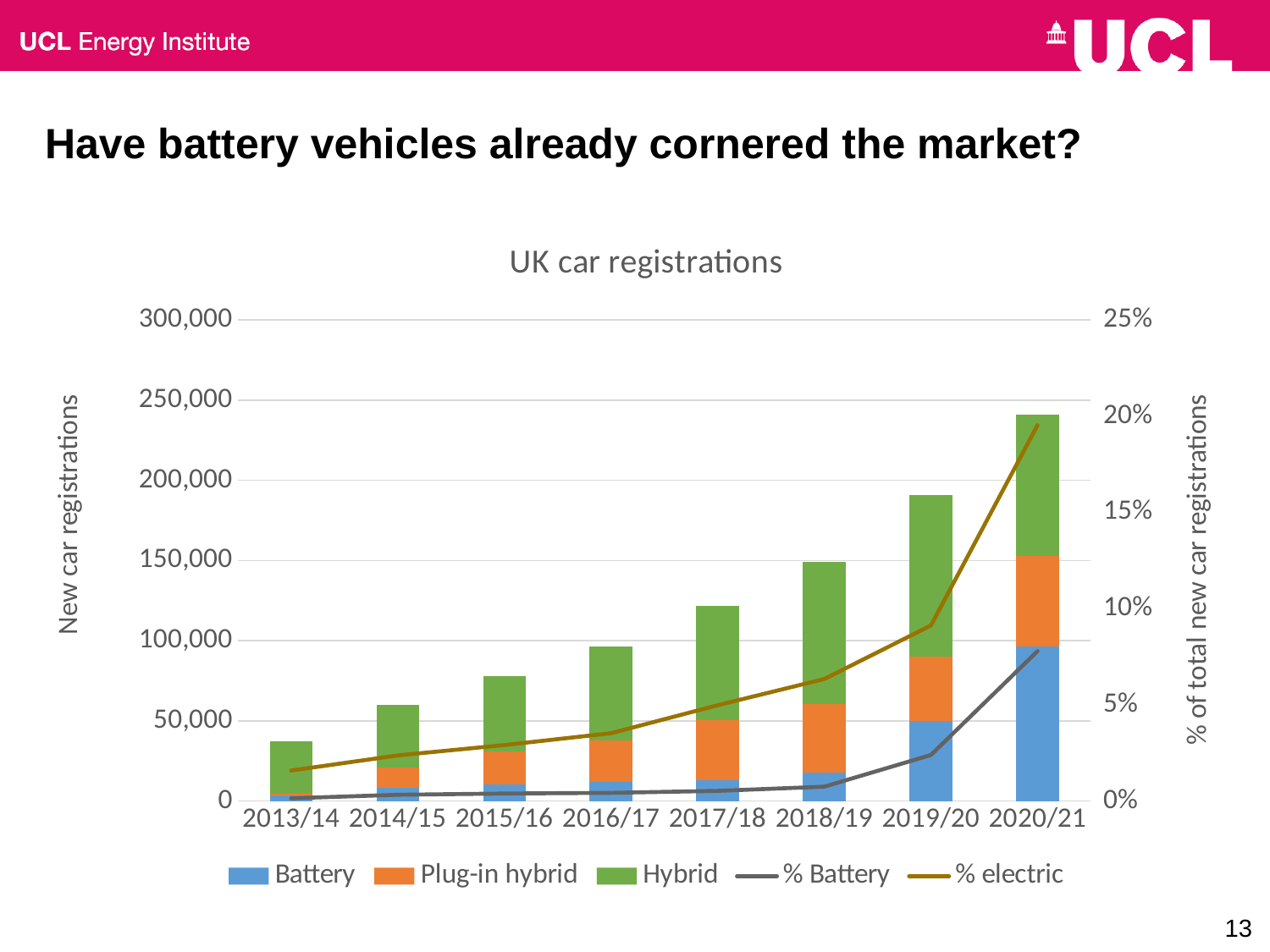
How many year categories are shown on the x axis? 8 Is the % electric value for 2020/21 greater or less than 15%? greater Do the total new car registrations rise or fall from 2013/14 to 2020/21? rise Which has the larger total stacked bar, 2018/19 or 2019/20? 2019/20 Is the total stacked bar for 2020/21 greater or less than 200,000? greater What kind of chart is shown on the slide? Combined stacked bar and line chart Which year has the highest total new car registrations bar? 2020/21 Is the total stacked bar for 2013/14 greater or less than 50,000? less How many series does the legend list? 5 What is the title of the chart? UK car registrations Which year has the lowest total new car registrations bar? 2013/14